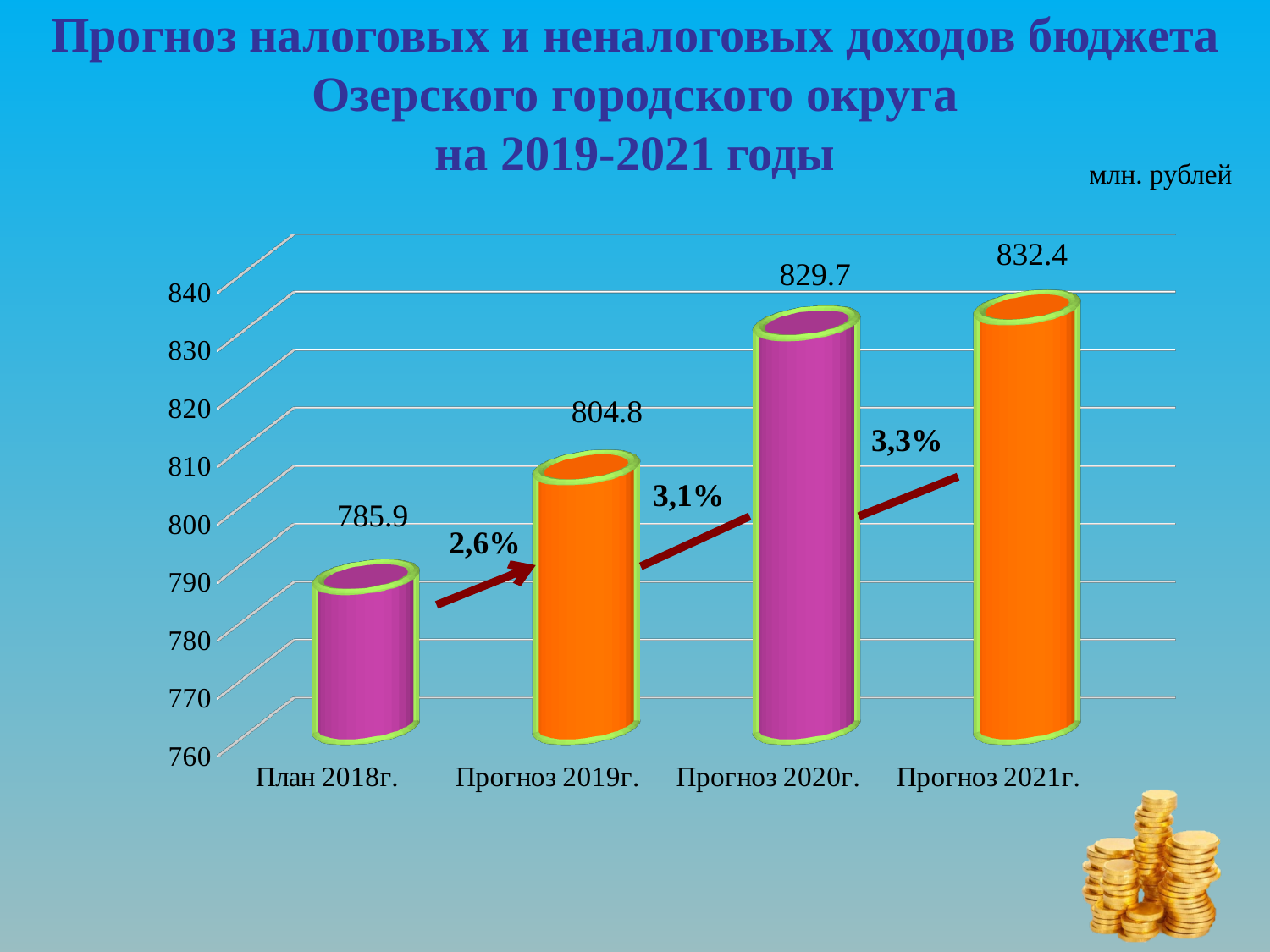
What is the difference between the values for Прогноз 2019г. and План 2018г.? 18.9 Which is larger, the value for Прогноз 2020г. or Прогноз 2019г.? Прогноз 2020г. What is the value for Прогноз 2021г.? 832.4 What is the value for Прогноз 2019г.? 804.8 What kind of chart is this? bar chart Which category has the lowest value? План 2018г. What is the value for Прогноз 2020г.? 829.7 How many categories are shown on the x axis? 4 What is the value for План 2018г.? 785.9 Do the values rise or fall from План 2018г. to Прогноз 2021г.? rise What unit is stated for the values on the chart? млн. рублей Which category has the highest value? Прогноз 2021г.